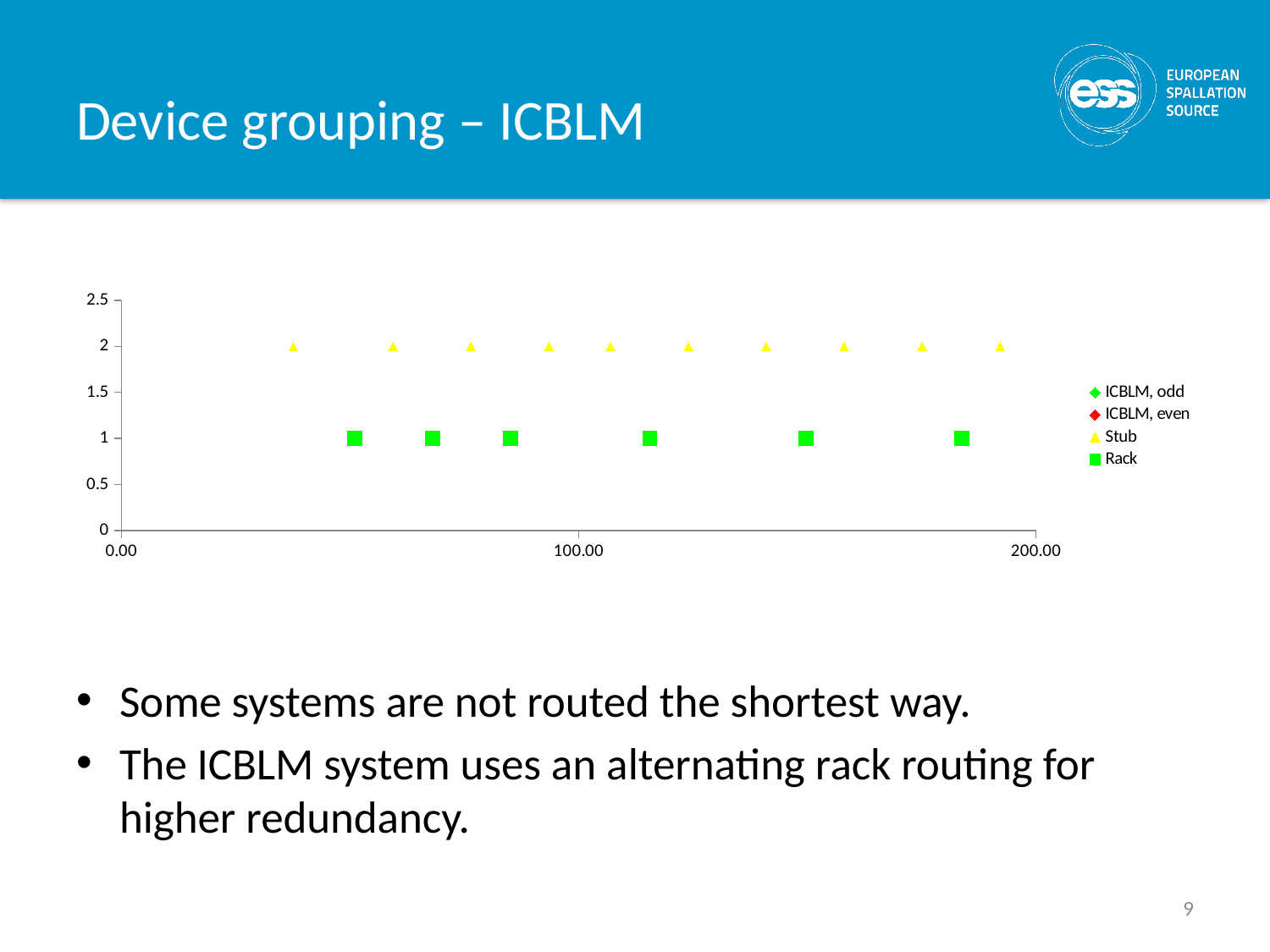
How many Rack points are plotted on the chart? 6 Is the y value of the Stub points greater or less than 1.5? greater What kind of chart is shown on the slide? Scatter chart At what y-axis value are the Rack points plotted? 1 What is the highest value shown on the chart's y axis? 2.5 Which series is plotted higher on the y axis, Stub or Rack? Stub What colour are the Rack markers in the chart? Green At what y-axis value are the Stub points plotted? 2 How many Stub points are plotted on the chart? 10 Is the y value of the Rack points greater or less than 1.5? less How many series does the chart's legend list? 4